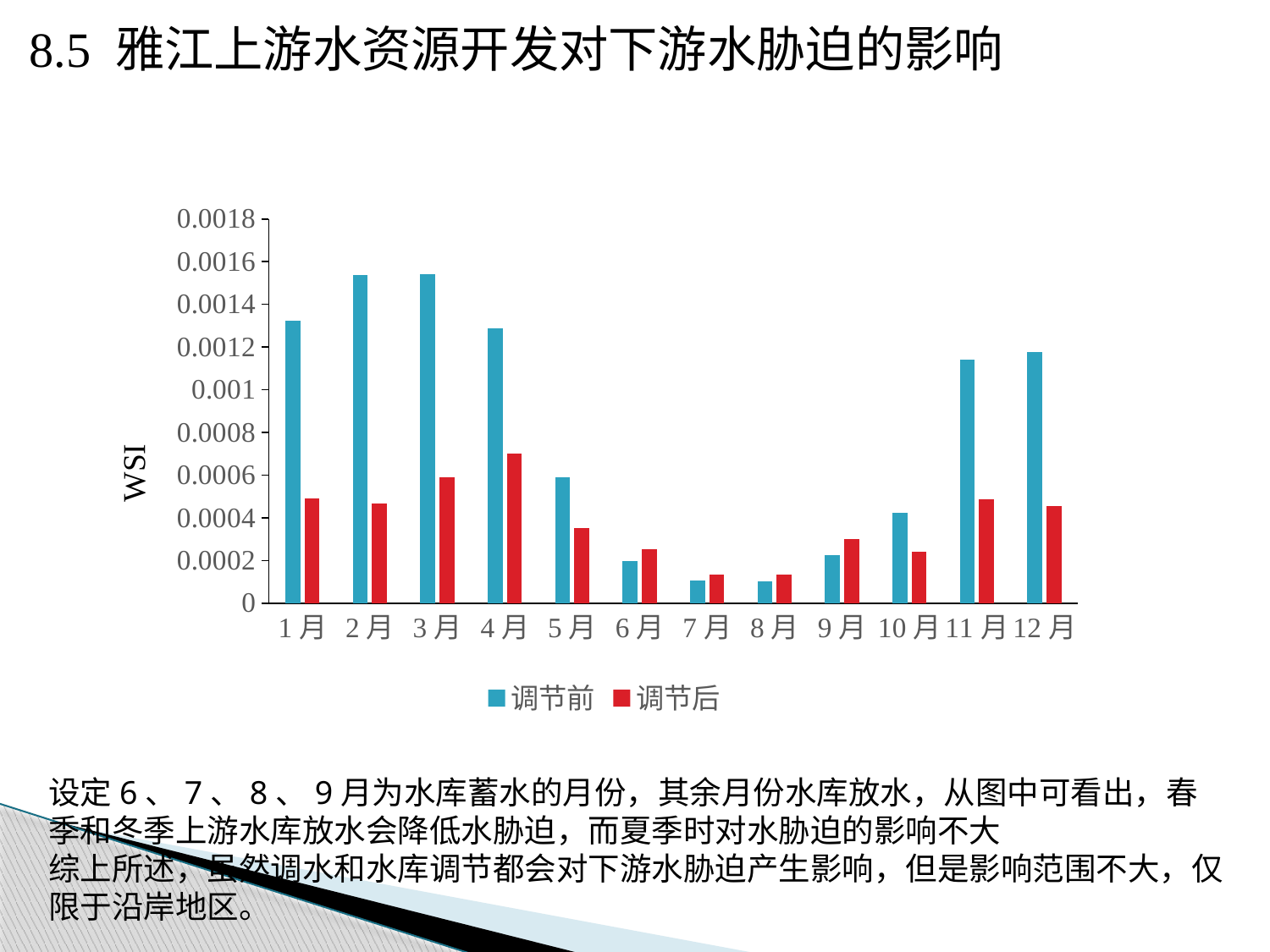
Is the 调节后 value for 4月 greater or less than 0.0006? greater For 1月, which series has the larger value, 调节前 or 调节后? 调节前 Is the 调节前 value for 6月 greater or less than 0.0004? less For 9月, which series has the larger value, 调节前 or 调节后? 调节后 Is the 调节前 value for 11月 greater or less than 0.001? greater What kind of chart is shown on the slide? bar chart What are the two series named in the legend? 调节前 and 调节后 In which month is the 调节后 value highest? 4月 How many series does the legend list? 2 What is the label on the vertical axis? WSI How many months (categories) are shown on the x axis? 12